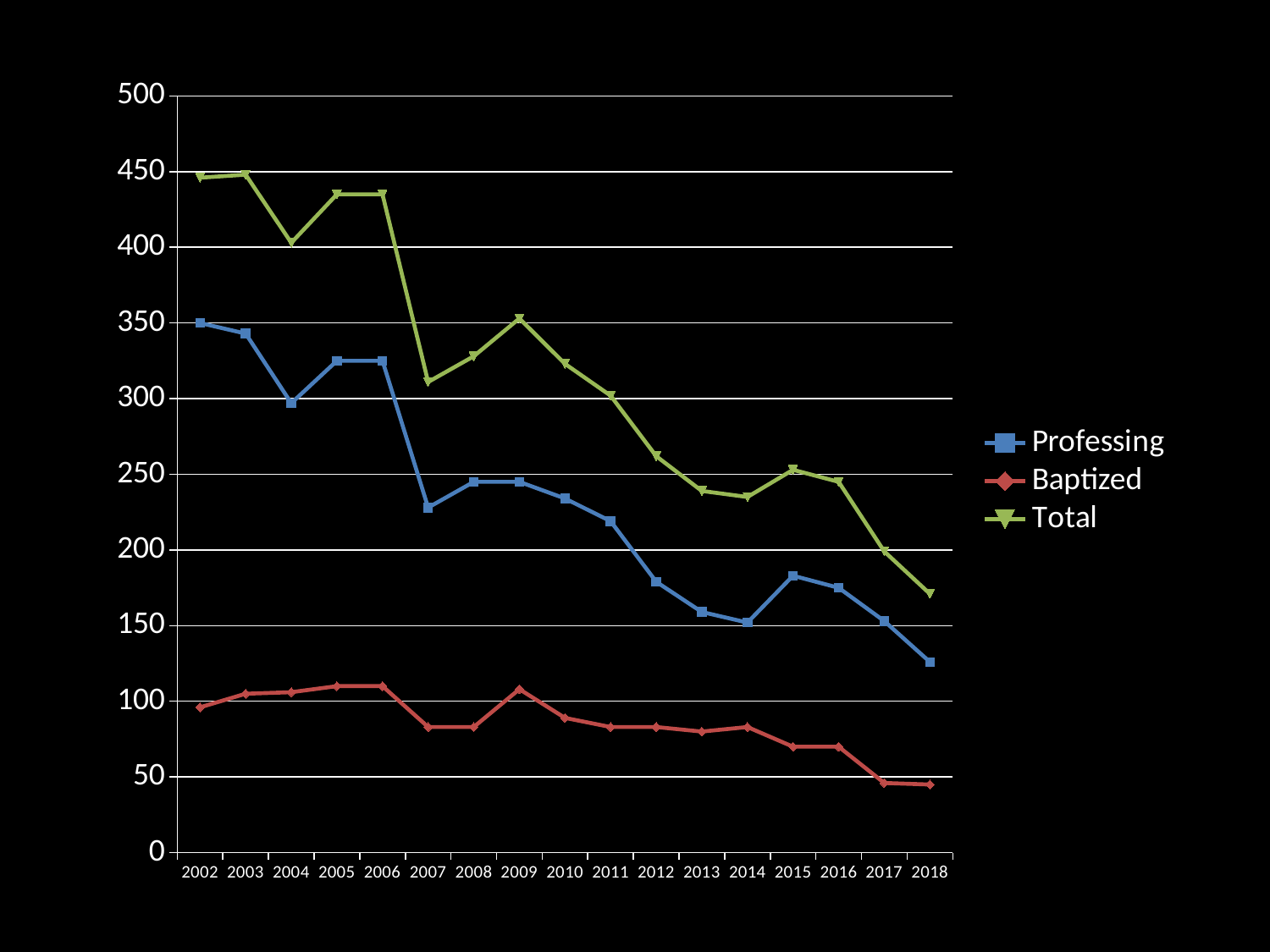
Is the value for Professing in 2007 greater or less than 250? less Is the value for Professing in 2018 greater or less than 150? less How many years are plotted along the x axis? 17 What kind of chart is shown on the slide? line chart Does the Total series rise or fall overall from 2002 to 2018? fall What colour is the line for the Total series? green Which is larger, the Professing value in 2014 or in 2015? 2015 Is the value for Total in 2002 greater or less than 400? greater How many series does the legend list? 3 In which year is the Total series at its lowest? 2018